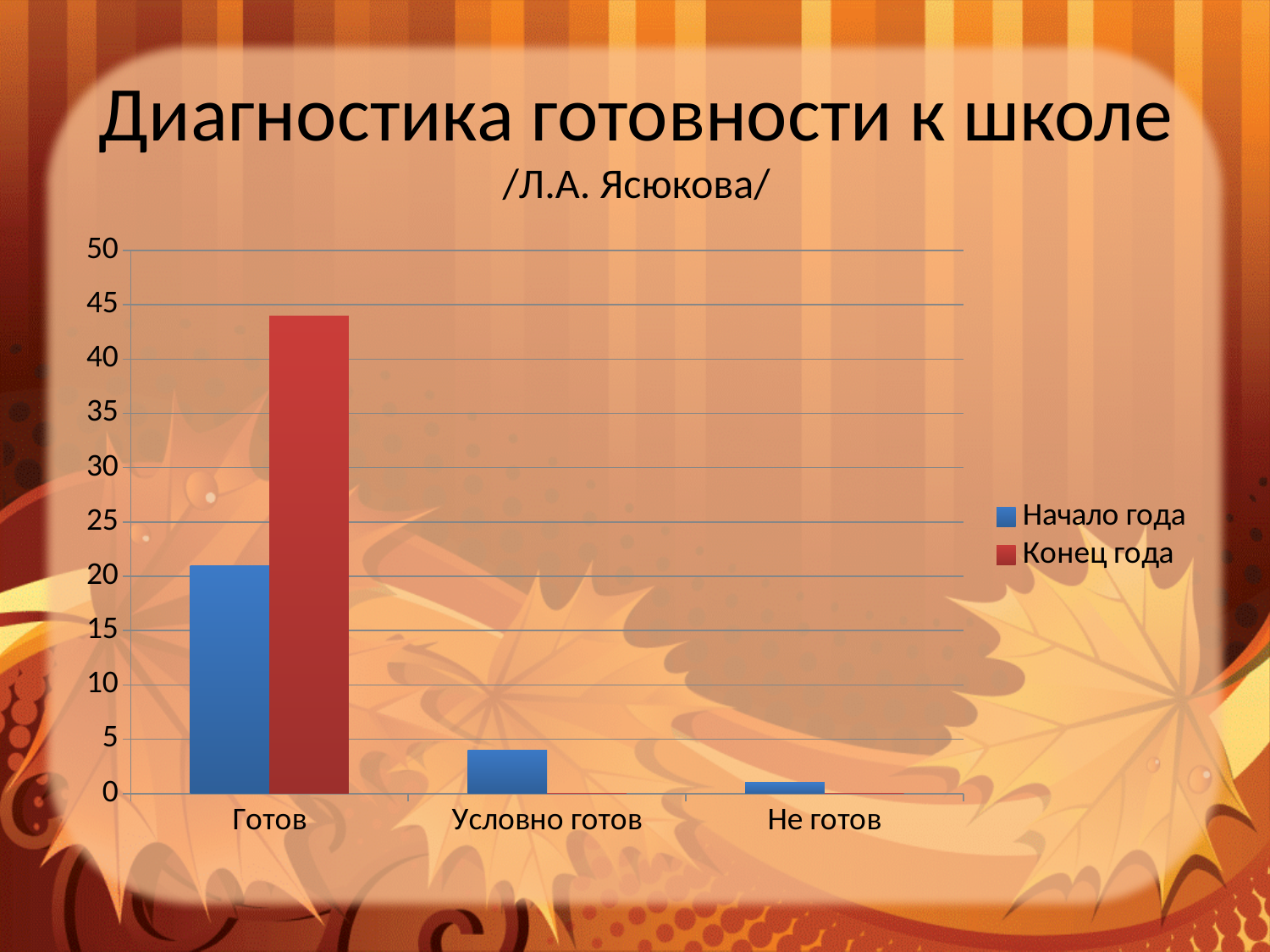
How many categories are shown on the x axis? 3 Which category has the highest value for the series Начало года? Готов Is the value for Готов in the series Конец года greater or less than 40? greater How many series does the legend list? 2 Is the value for Условно готов in the series Начало года greater or less than 5? less Which category has the lowest value for the series Начало года? Не готов For the category Готов, which series has the larger value, Начало года or Конец года? Конец года Is the value for Не готов in the series Начало года greater or less than 5? less Do the values for the series Начало года rise or fall from left to right along the x axis? fall What colour are the bars for the series Конец года? red What kind of chart is shown on the slide? bar chart